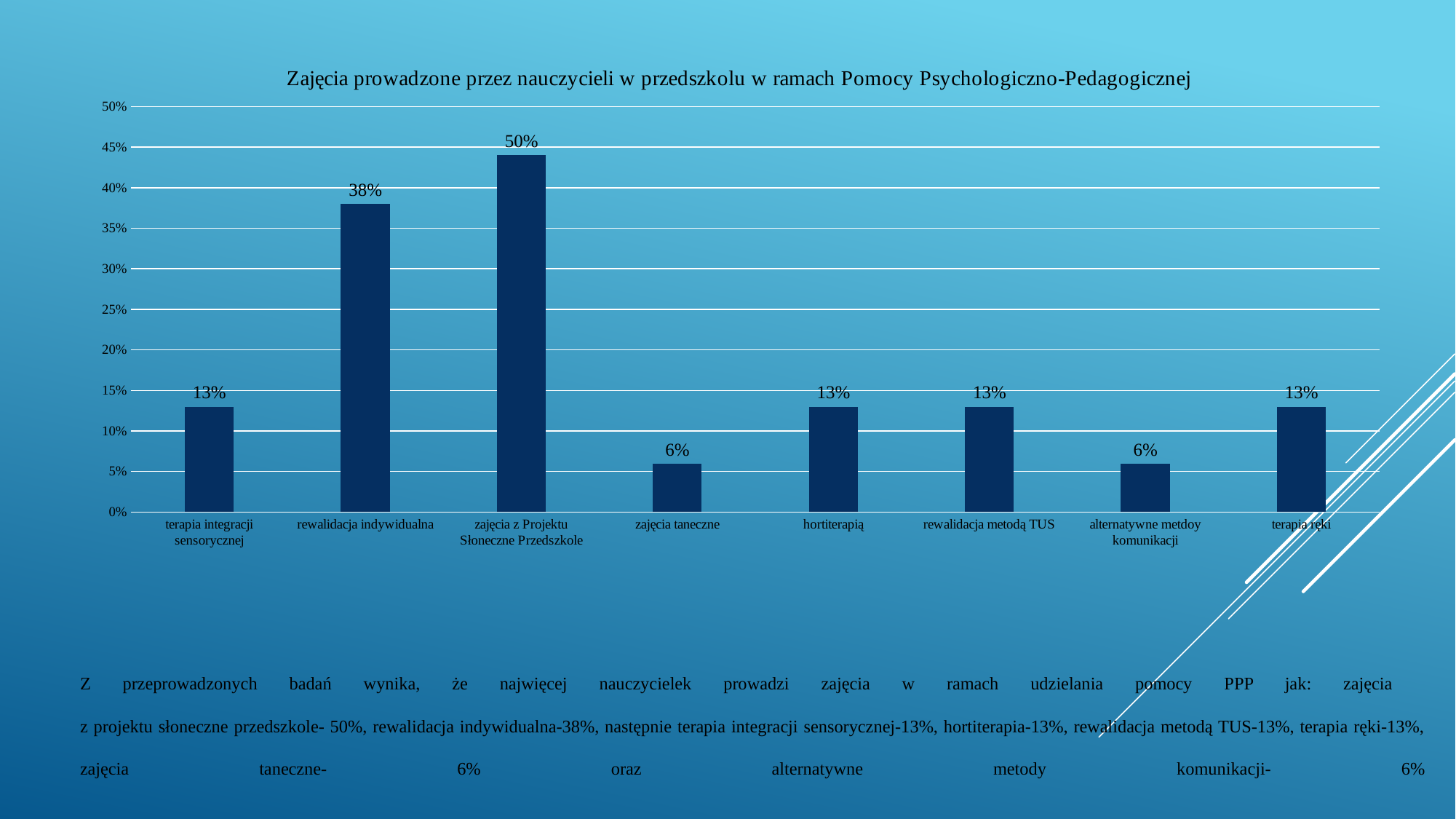
What is the value for hortiterapią? 13% What is the value for zajęcia taneczne? 6% What is the title of the chart? Zajęcia prowadzone przez nauczycieli w przedszkolu w ramach Pomocy Psychologiczno-Pedagogicznej What is the value for alternatywne metdoy komunikacji? 6% How many categories are shown on the x axis? 8 Is the value for terapia integracji sensorycznej greater or less than 20%? less What is the difference between the values for terapia ręki and zajęcia taneczne? 7% Which is larger, the value for rewalidacja indywidualna or the value for rewalidacja metodą TUS? rewalidacja indywidualna Which category has the highest value? zajęcia z Projektu Słoneczne Przedszkole What kind of chart is shown on the slide? bar chart What is the value for rewalidacja indywidualna? 38%